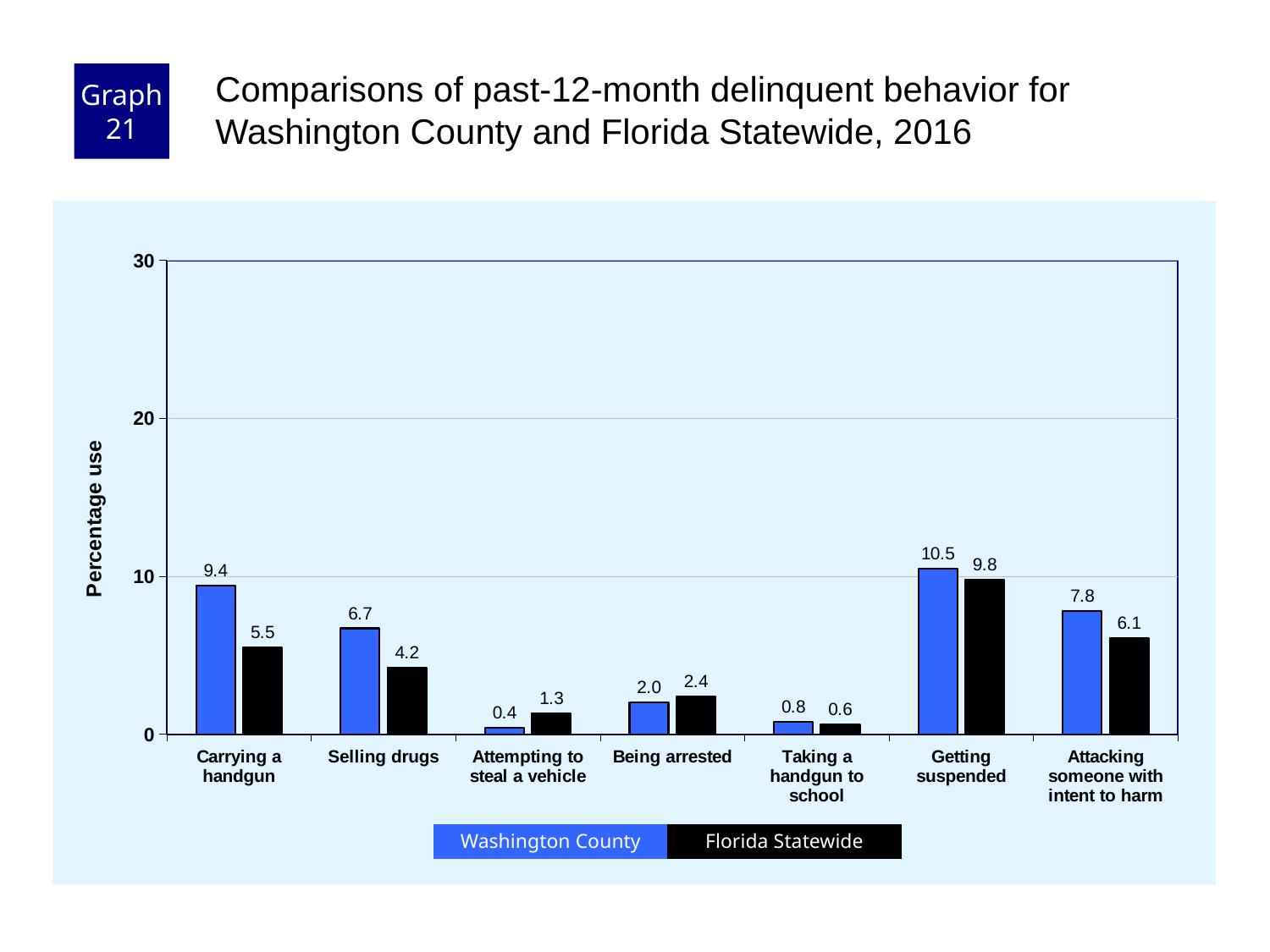
Which category has the highest Washington County value? Getting suspended Is the Washington County value for Getting suspended greater or less than 10? greater How many series does the legend list? 2 For Being arrested, which is larger: the Washington County value or the Florida Statewide value? Florida Statewide What is the difference between the Washington County and Florida Statewide values for Carrying a handgun? 3.9 What is the Washington County value for Carrying a handgun? 9.4 What kind of chart is shown on the slide? bar chart How many categories are shown on the x axis? 7 What is the label of the y axis? Percentage use What is the Florida Statewide value for Selling drugs? 4.2 What is the Washington County value for Getting suspended? 10.5 Which category has the lowest Florida Statewide value? Taking a handgun to school